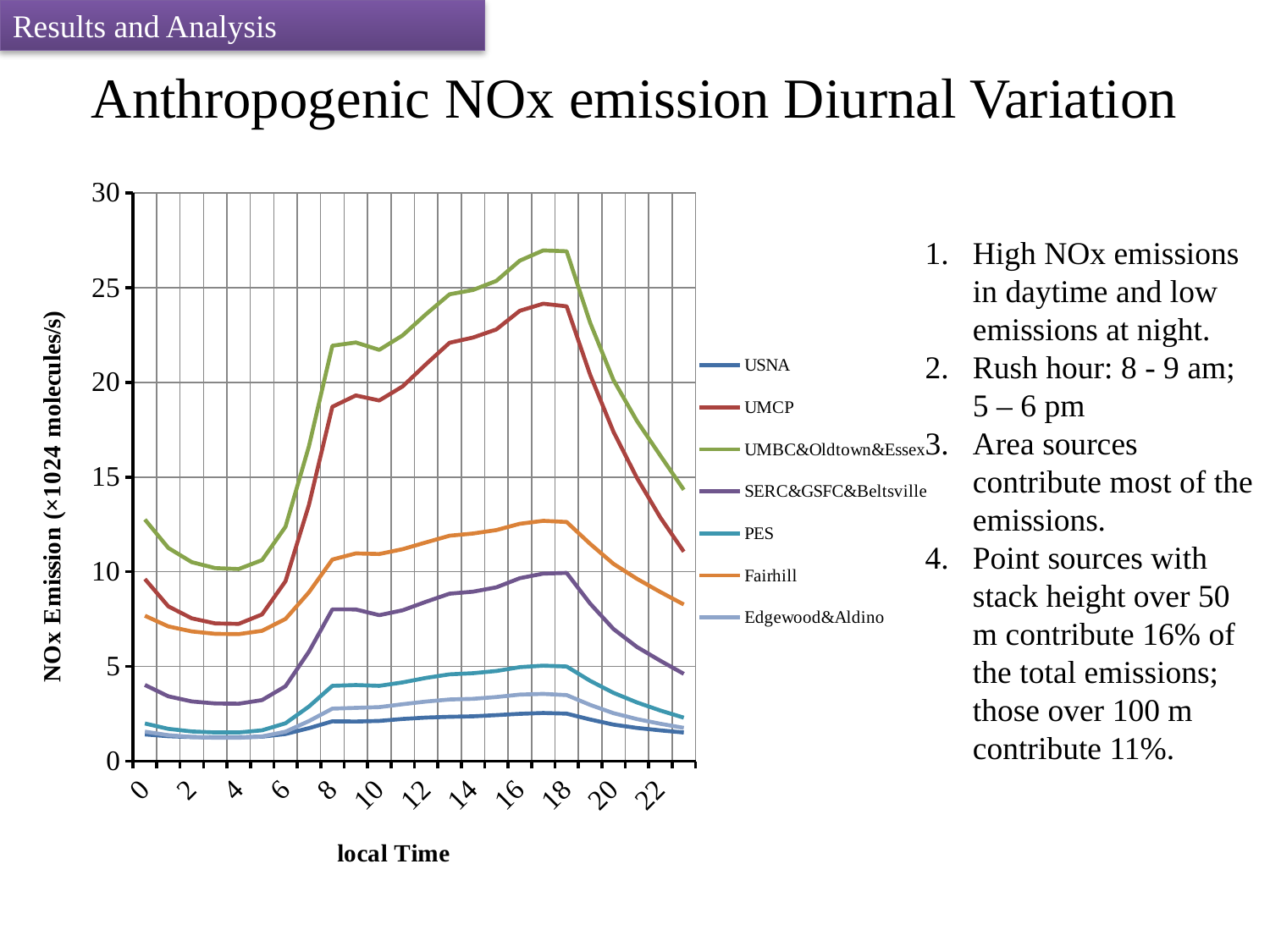
Which series has the highest NOx emission values across the day? UMBC&Oldtown&Essex At local time 12, which series has the larger value, UMCP or SERC&GSFC&Beltsville? UMCP What is the title of the horizontal axis? local Time What is the title of the vertical axis? NOx Emission (×1024 molecules/s) Is the value for Fairhill at local time 18 greater or less than 10? greater Is the value for UMCP at local time 4 greater or less than 10? less Is the value for UMBC&Oldtown&Essex at local time 17 greater or less than 25? greater What kind of chart is shown on the slide? line chart At local time 17, which series has the lowest NOx emission? USNA Do the values for UMCP rise or fall between local time 6 and local time 8? rise Do the values for UMBC&Oldtown&Essex rise or fall between local time 18 and local time 22? fall How many series does the legend list? 7